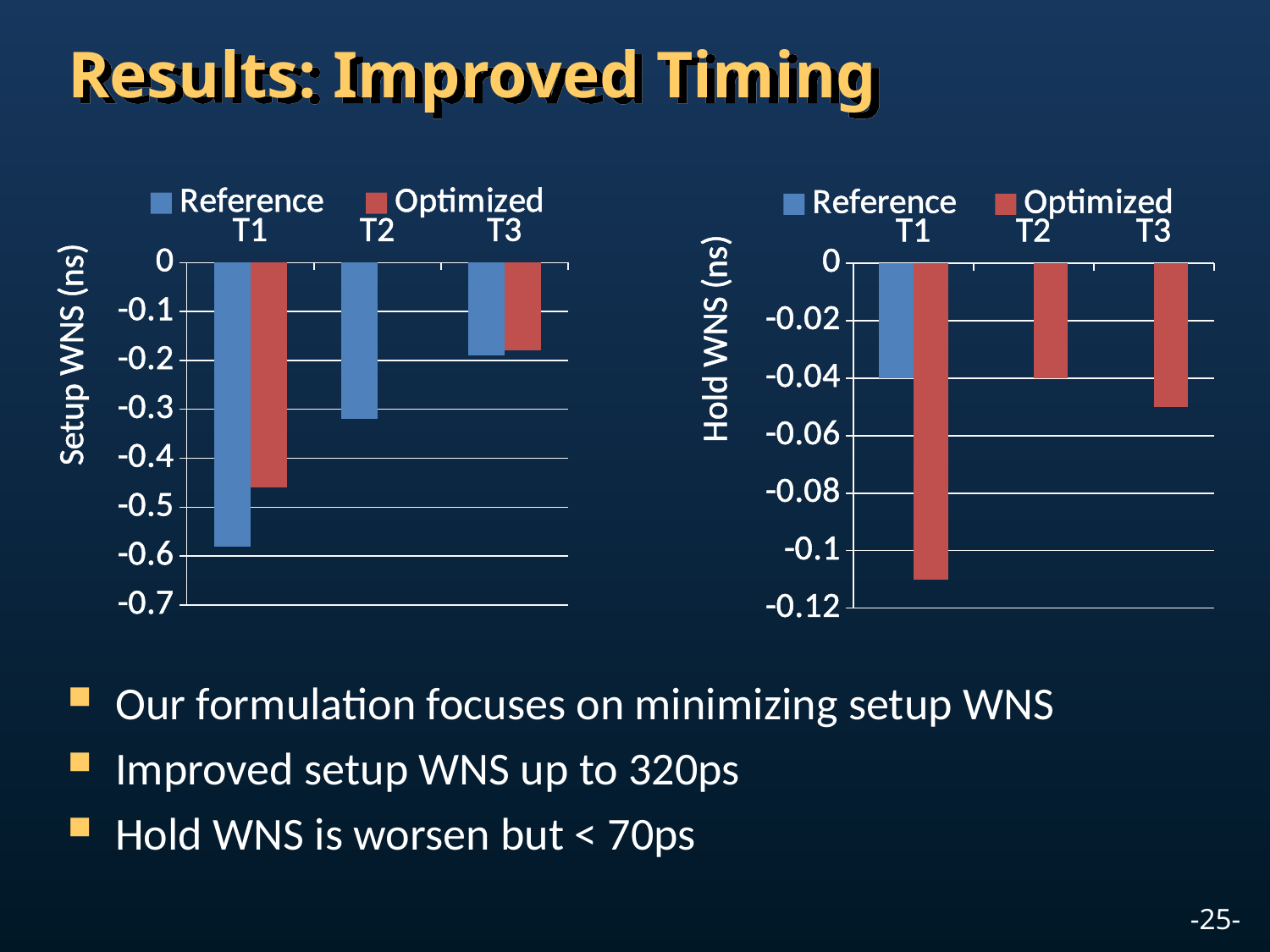
In the Setup WNS (ns) chart, for T1, which series has the more negative value, Reference or Optimized? Reference In the Hold WNS (ns) chart, is the Optimized value for T1 greater or less than -0.08? less In the Hold WNS (ns) chart, which category has the most negative Optimized value? T1 In the Hold WNS (ns) chart, is the Optimized value for T3 greater or less than -0.08? greater What kind of chart is the Setup WNS (ns) chart on the left? bar chart How many series does the legend of the Hold WNS (ns) chart list? 2 How many categories are shown on the x axis of the Setup WNS (ns) chart? 3 In the Hold WNS (ns) chart, what is the Reference value for T1? -0.04 In the Setup WNS (ns) chart, is the Reference value for T1 greater or less than -0.5? less In the Setup WNS (ns) chart, what colour represents the Optimized series? red